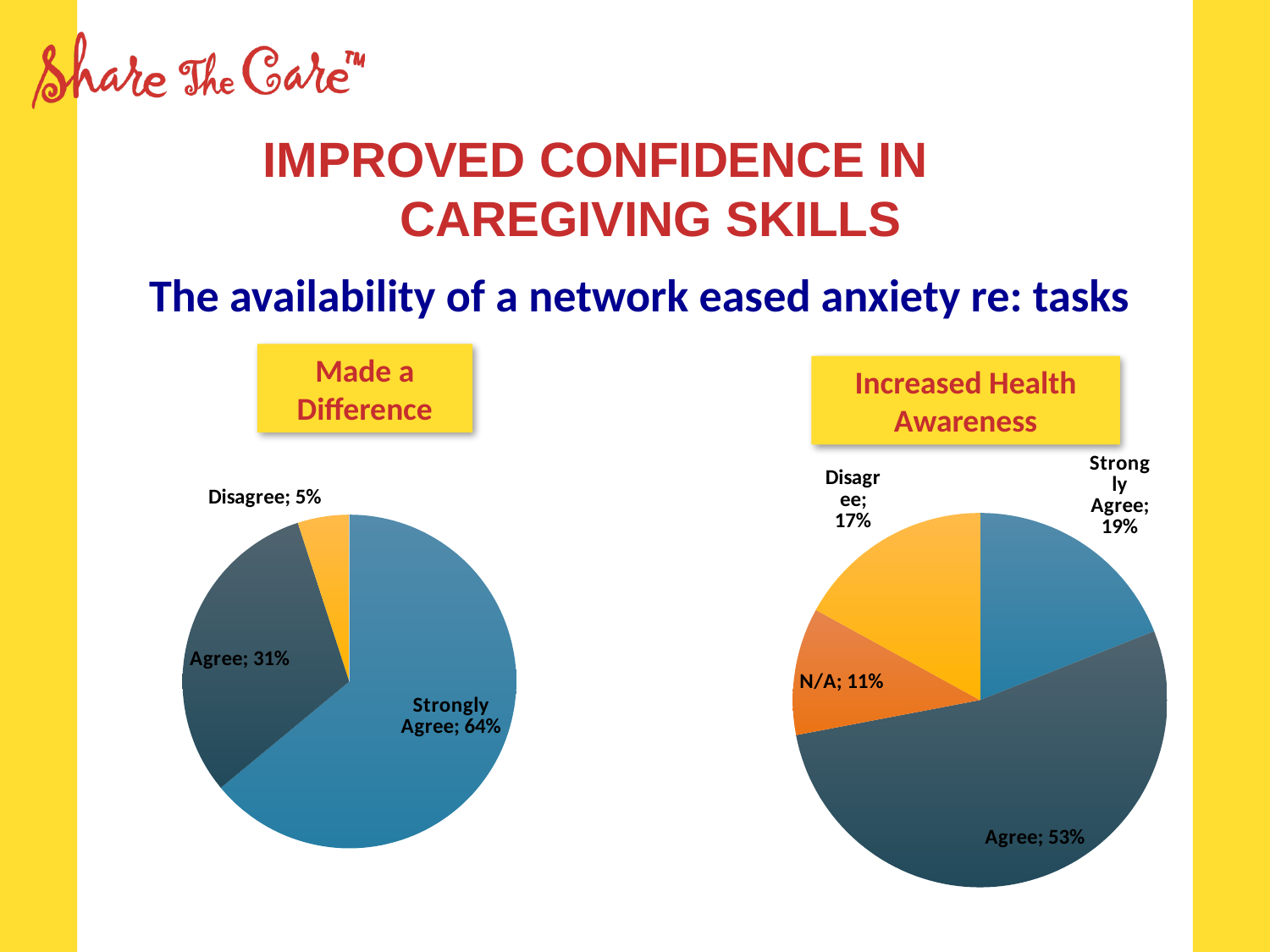
In the "Increased Health Awareness" pie chart, what percentage is shown for Agree? 53% How many slices does the "Increased Health Awareness" pie chart have? 4 What type of chart is used for "Made a Difference"? Pie chart In the "Increased Health Awareness" pie chart, which category has the smallest share? N/A In the "Made a Difference" pie chart, what percentage is shown for Disagree? 5% In the "Made a Difference" pie chart, what is the difference between the Strongly Agree and Agree percentages? 33% In the "Increased Health Awareness" pie chart, what is the difference between the Strongly Agree and Disagree percentages? 2% In the "Made a Difference" pie chart, what percentage is shown for Strongly Agree? 64% In the "Made a Difference" pie chart, which category has the largest share? Strongly Agree In the "Increased Health Awareness" pie chart, what percentage is shown for N/A? 11% How many slices does the "Made a Difference" pie chart have? 3 In the "Increased Health Awareness" pie chart, which is larger, Agree or Strongly Agree? Agree